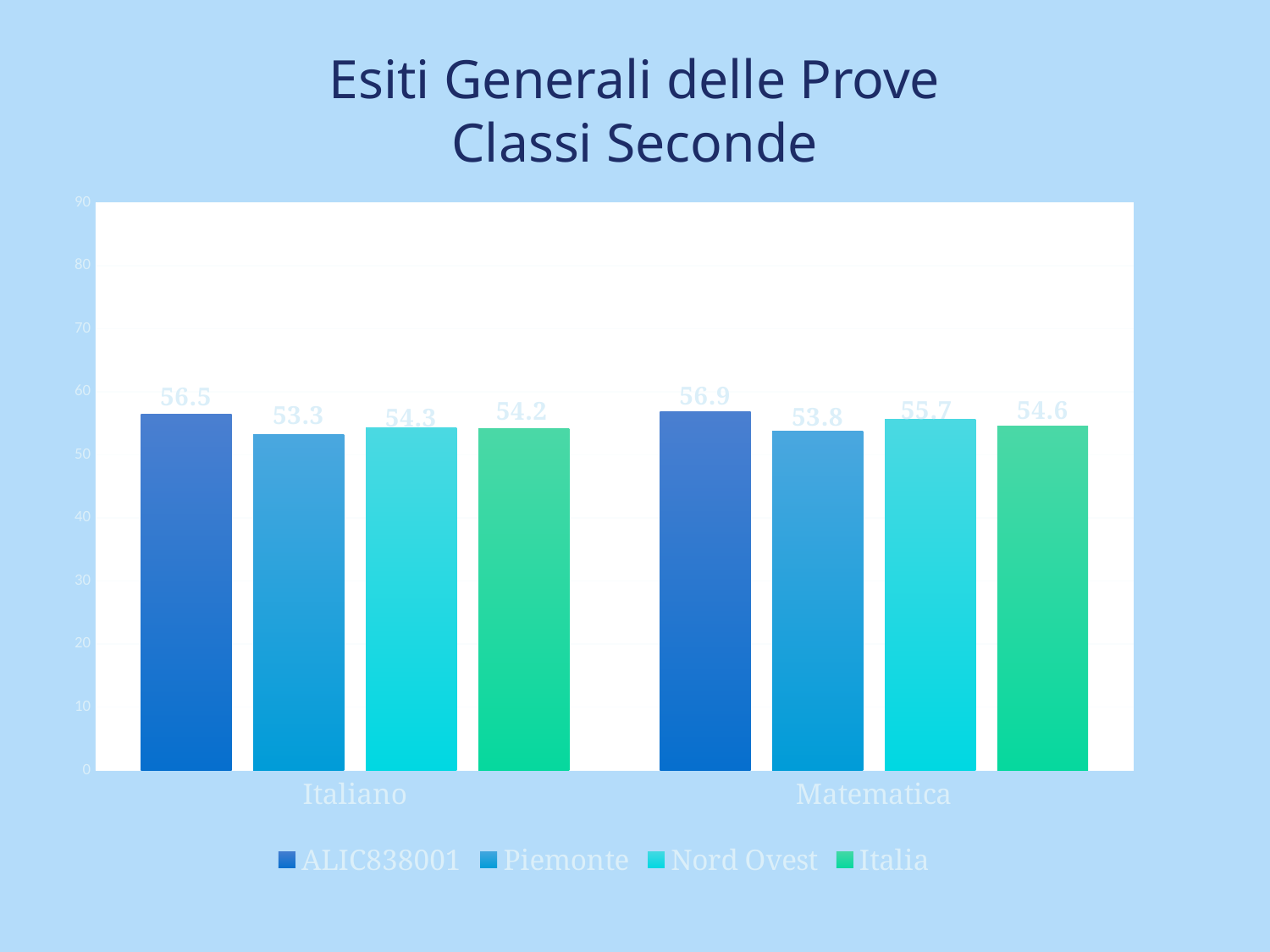
What is the value for Italia in Matematica? 54.6 What is the value for Nord Ovest in Matematica? 55.7 What kind of chart is shown on the slide? Bar chart What is the title of the chart? Esiti Generali delle Prove Classi Seconde How many series does the legend list? 4 What is the value for Piemonte in Italiano? 53.3 What is the value for ALIC838001 in Italiano? 56.5 Which series has the highest value in Matematica? ALIC838001 What is the difference between the ALIC838001 value and the Piemonte value in Matematica? 3.1 Which is larger: the Nord Ovest value in Italiano or the Nord Ovest value in Matematica? Matematica Which series has the lowest value in Italiano? Piemonte Is the value for Italia in Italiano greater or less than 50? greater